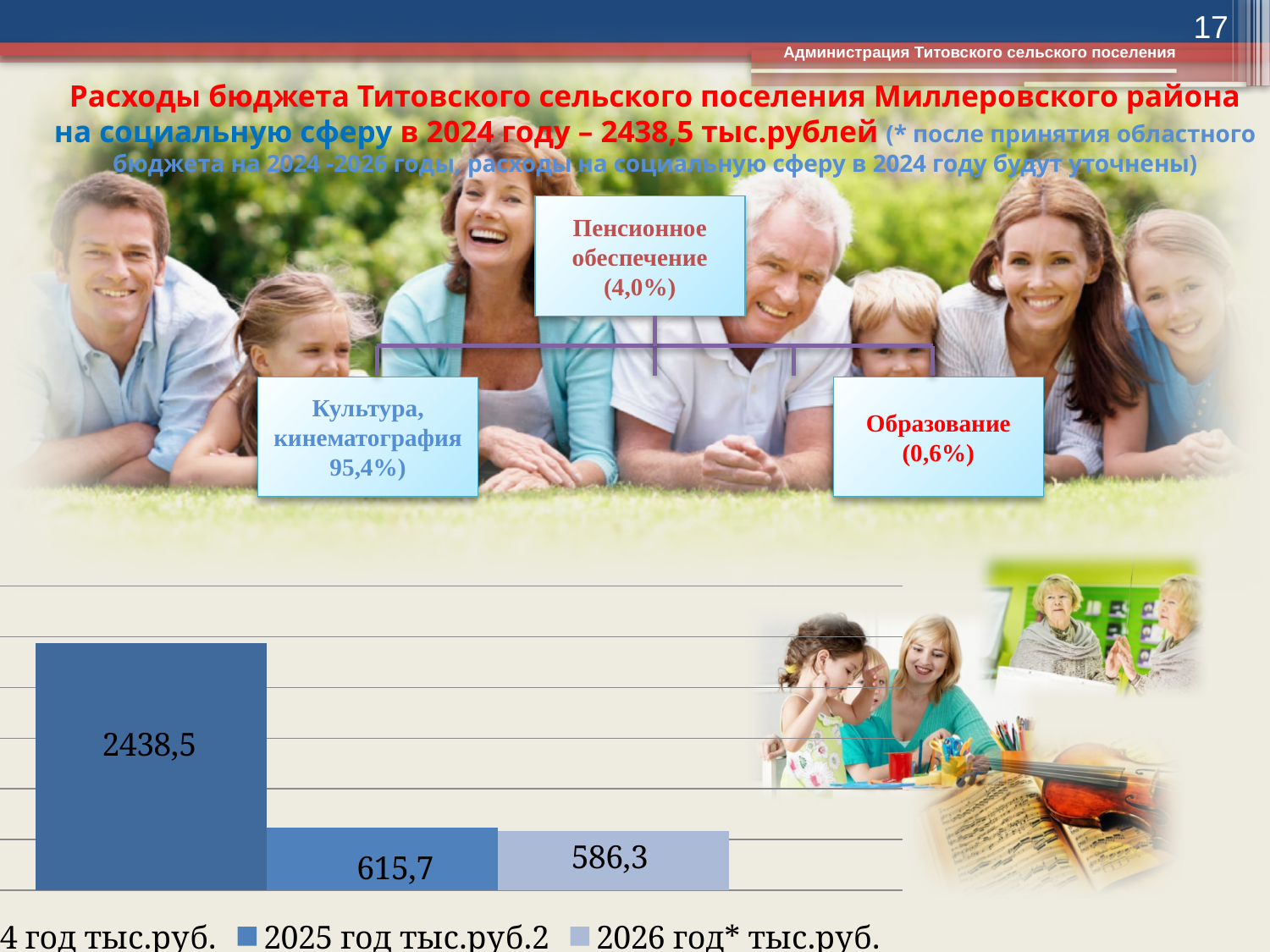
How many series does the legend of the bar chart list? 3 Do the values in the bar chart rise or fall from left to right? Fall What is the difference between the 2025 год bar and the 2026 год* bar in the bar chart? 29,4 Which is larger in the bar chart: the value for 2025 год or for 2026 год*? 2025 год What is the difference between the 2024 bar (2438,5) and the 2025 год bar in the bar chart? 1822,8 What kind of chart is shown at the bottom of the slide? Bar chart Which year has the highest value in the bar chart? 2024 год What value is shown on the bar for 2025 год in the bar chart? 615,7 Which year has the lowest value in the bar chart? 2026 год* What value is shown on the bar for 2026 год* in the bar chart? 586,3 How many bars are plotted in the bar chart? 3 What value is shown on the tallest bar in the bar chart? 2438,5